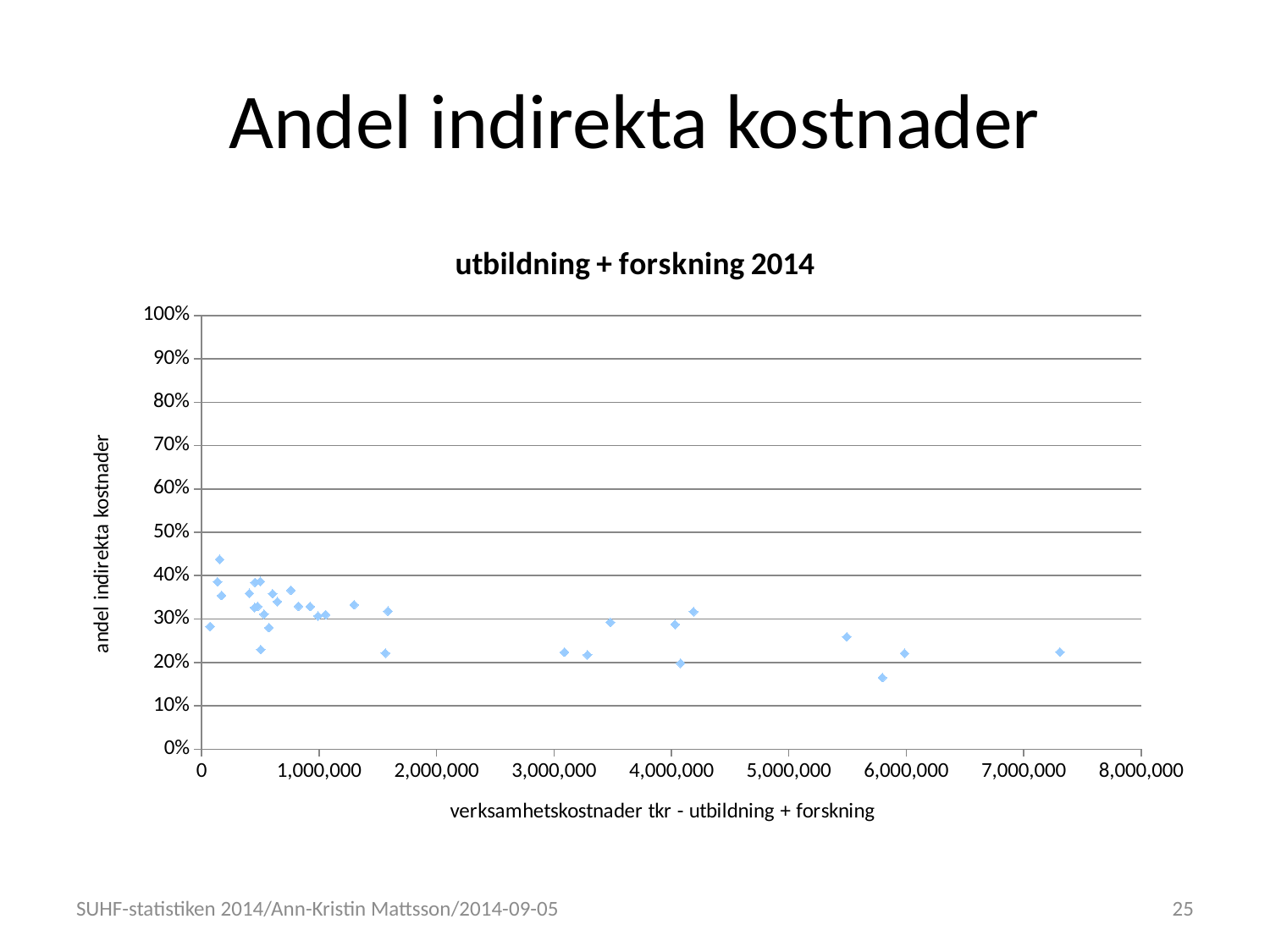
Which is larger: the highest point near 150,000 or the point near 5,750,000? the point near 150,000 Is the value for the point near 1,300,000 greater or less than 30%? greater Is the value for the rightmost point (near 7,000,000) greater or less than 30%? less Is the highest point on the chart greater or less than 40%? greater What is the title of the chart? utbildning + forskning 2014 What is the label of the x axis of the chart? verksamhetskostnader tkr - utbildning + forskning What kind of chart is shown on the slide? scatter chart Do the plotted values generally rise or fall as the x-axis value increases? fall